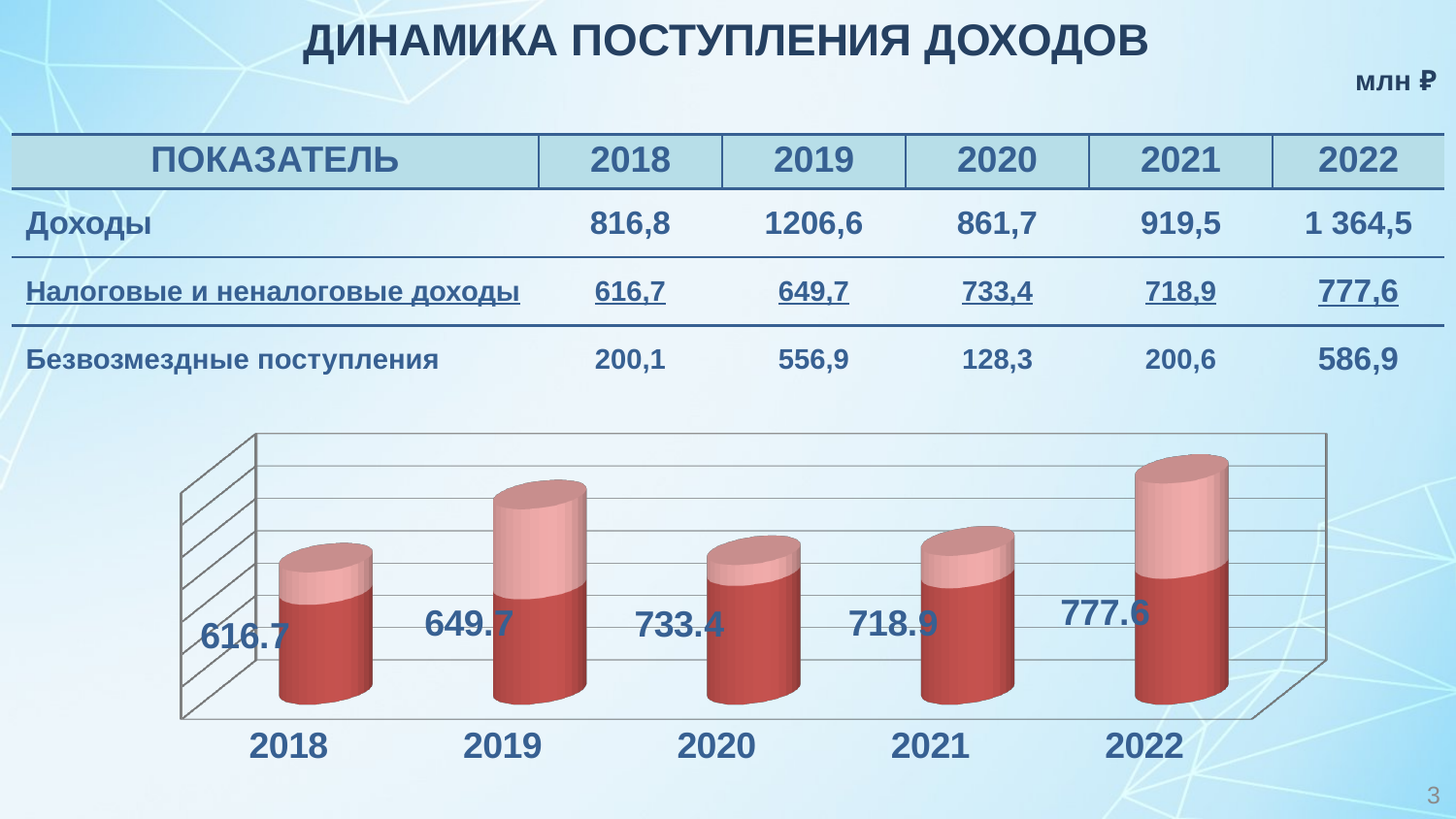
Which year has the lowest labeled value in the chart? 2018 What is the difference between the labeled values for 2022 and 2018? 160.9 What is the difference between the labeled values for 2020 and 2019? 83.7 How many years are shown on the x axis of the chart? 5 What value is labeled on the bar for 2018? 616.7 Does the labeled value rise or fall from 2018 to 2019? rise Which has the larger labeled value, 2020 or 2021? 2020 What value is labeled on the bar for 2022? 777.6 Which year has the highest labeled value in the chart? 2022 What value is labeled on the bar for 2021? 718.9 What kind of chart is shown on the slide? bar chart What is the title of the slide above the chart? ДИНАМИКА ПОСТУПЛЕНИЯ ДОХОДОВ